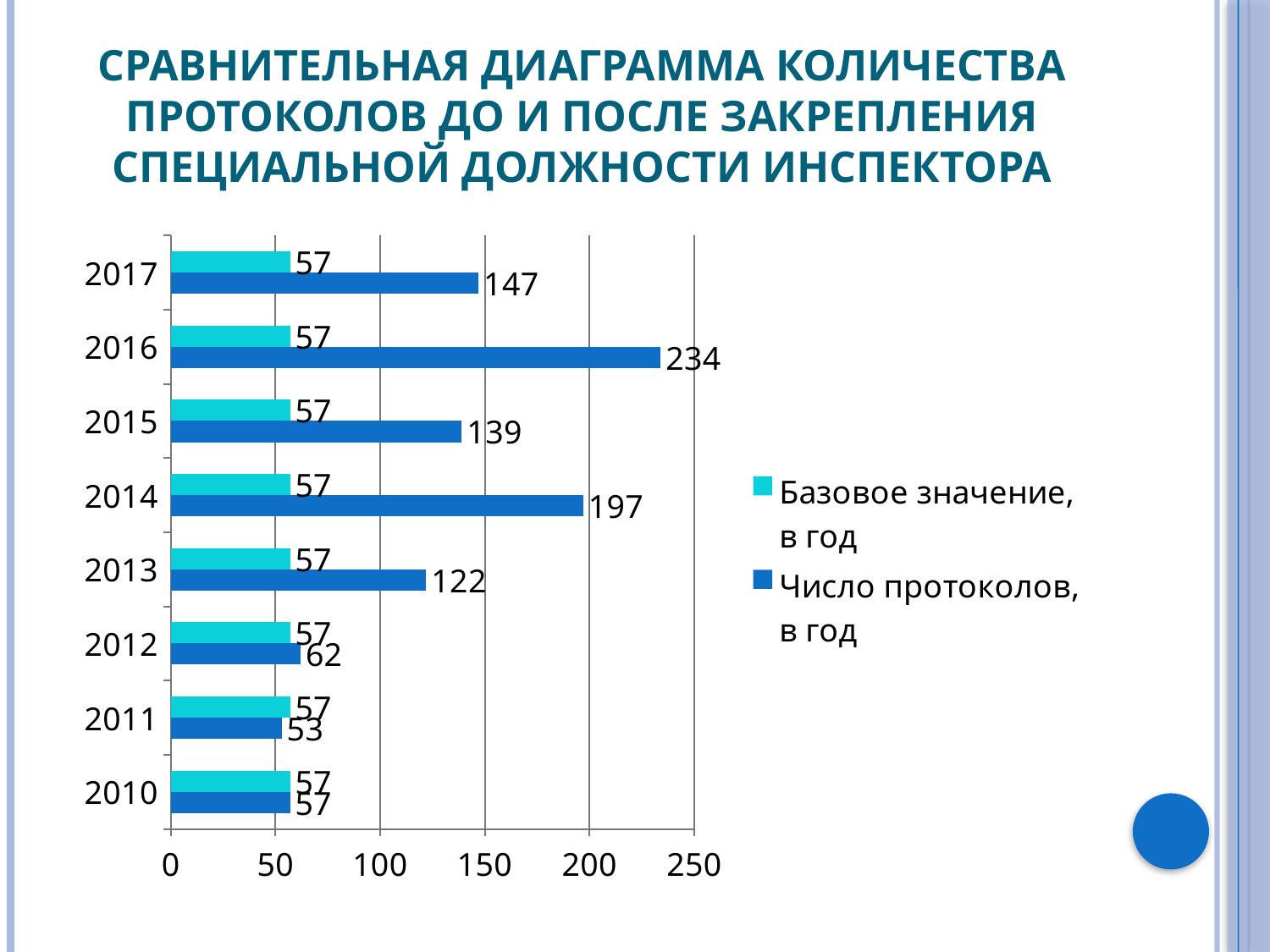
How many series does the legend list? 2 Which is larger: "Число протоколов, в год" for 2014 or for 2015? 2014 What kind of chart is shown on the slide? bar chart Which year has the lowest value for "Число протоколов, в год"? 2011 What is the value of "Число протоколов, в год" for 2013? 122 What colour are the bars for "Базовое значение, в год"? light blue (cyan) What is the value of "Число протоколов, в год" for 2016? 234 What is the difference between "Число протоколов, в год" for 2016 and 2017? 87 Which year has the highest value for "Число протоколов, в год"? 2016 How many years are shown on the chart? 8 Is the value of "Число протоколов, в год" for 2014 greater or less than 150? greater What is the value of "Базовое значение, в год" for 2014? 57